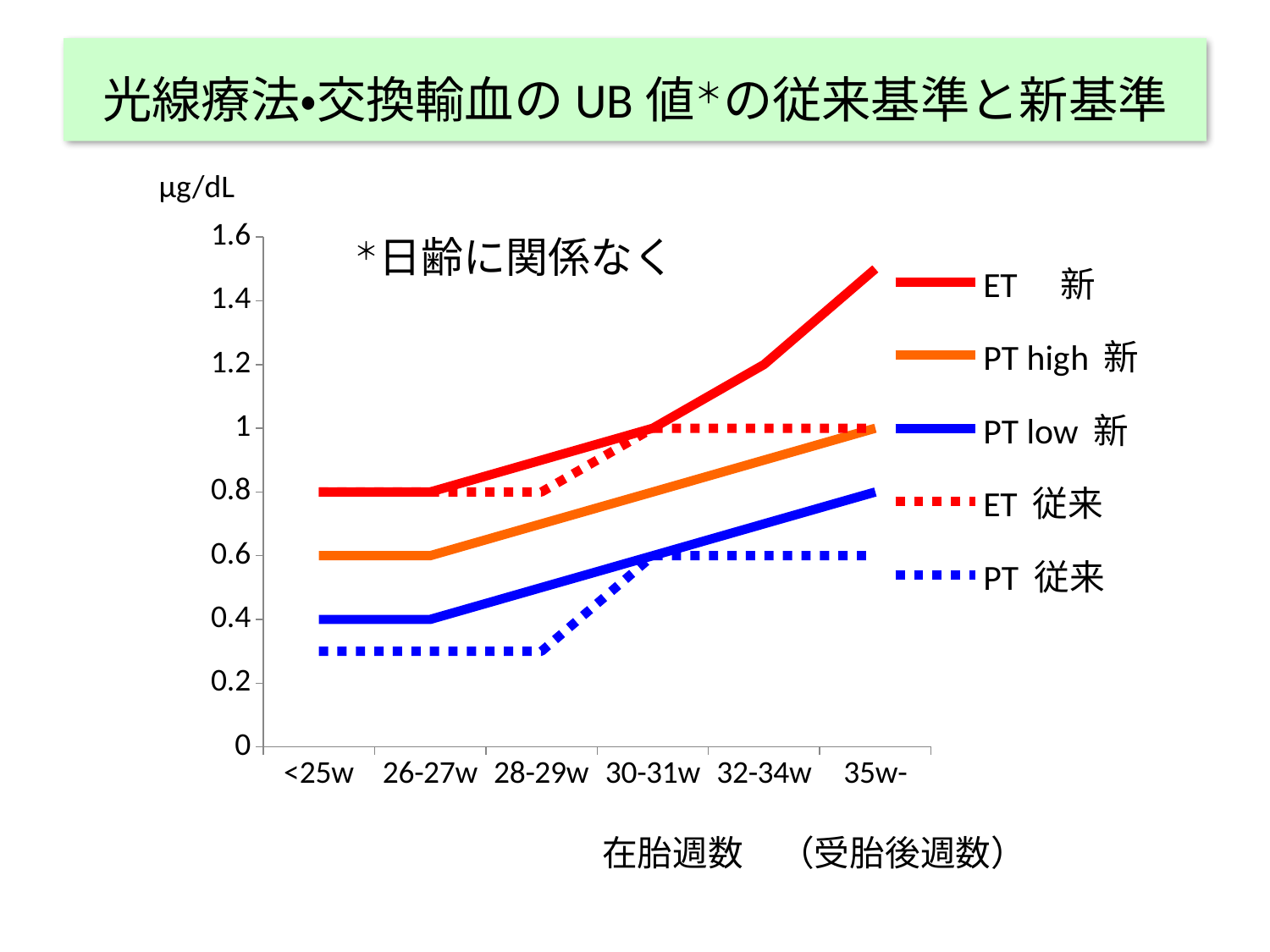
Is the value for PT 従来 at <25w greater or less than 0.4? less What is the value of ET 従来 at 35w-? 1 What is the value of PT low 新 at <25w? 0.4 How many series does the legend list? 5 Do the values of ET 新 rise or fall as gestational weeks increase along the x axis? rise At 35w-, which is larger: ET 新 or PT low 新? ET 新 What is the value of PT high 新 at 35w-? 1 Is the value for ET 新 at 35w- greater or less than 1.4? greater What is the difference between PT high 新 and PT low 新 at <25w? 0.2 What kind of chart is shown on the slide? line chart How many gestational-week categories are shown on the x axis? 6 What is the value of ET 新 at <25w? 0.8